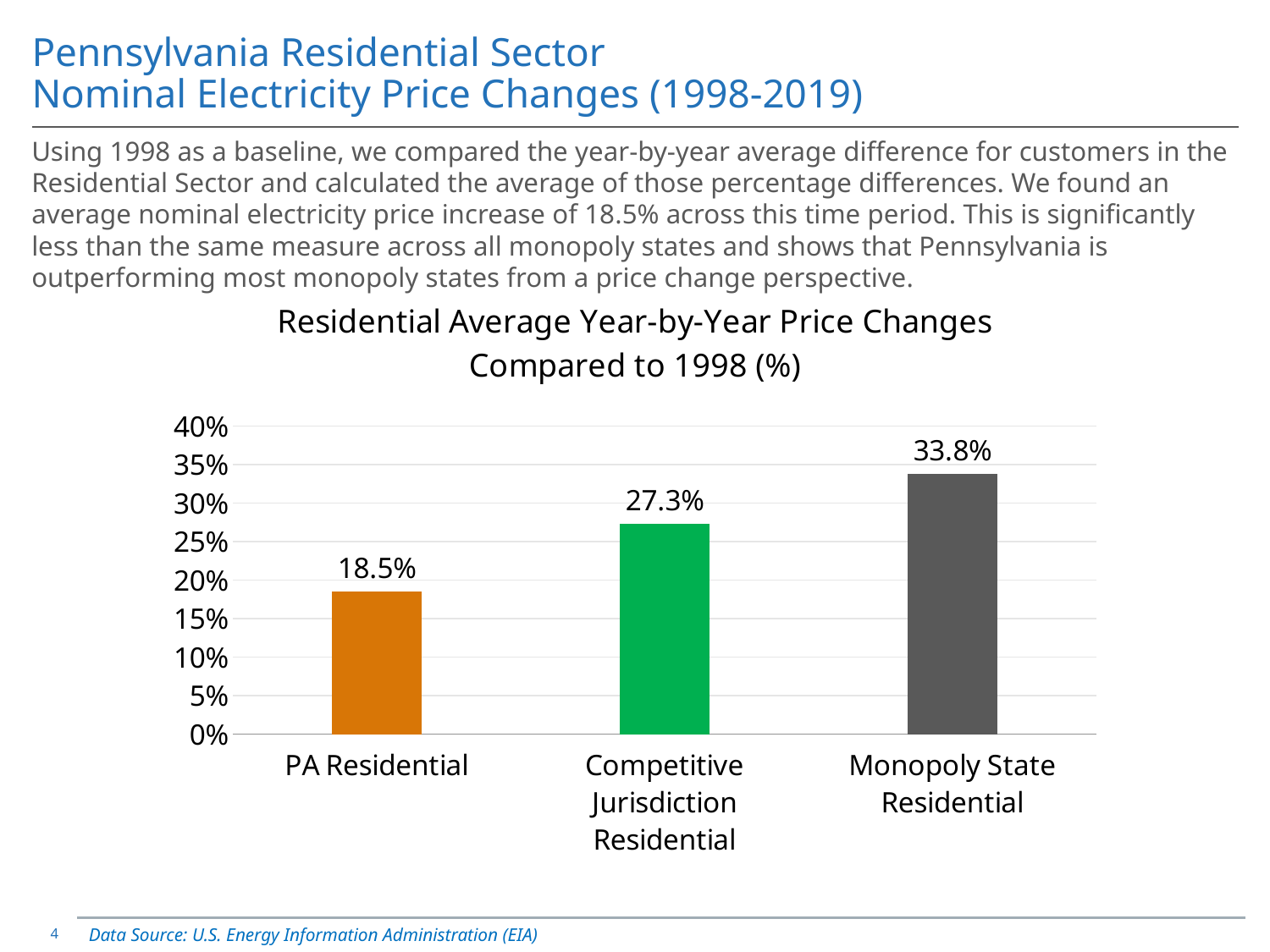
What is the value for PA Residential? 18.5% What is the value for Monopoly State Residential? 33.8% What is the title of the chart? Residential Average Year-by-Year Price Changes Compared to 1998 (%) Which category has the lowest value? PA Residential Which is larger, the value for PA Residential or the value for Competitive Jurisdiction Residential? Competitive Jurisdiction Residential What is the difference between the Competitive Jurisdiction Residential value and the PA Residential value? 8.8% What is the value for Competitive Jurisdiction Residential? 27.3% What kind of chart is shown on the slide? bar chart What is the difference between the Monopoly State Residential value and the PA Residential value? 15.3% Which category has the highest value? Monopoly State Residential How many categories are shown in the chart? 3 Is the value for Monopoly State Residential greater or less than 30%? greater